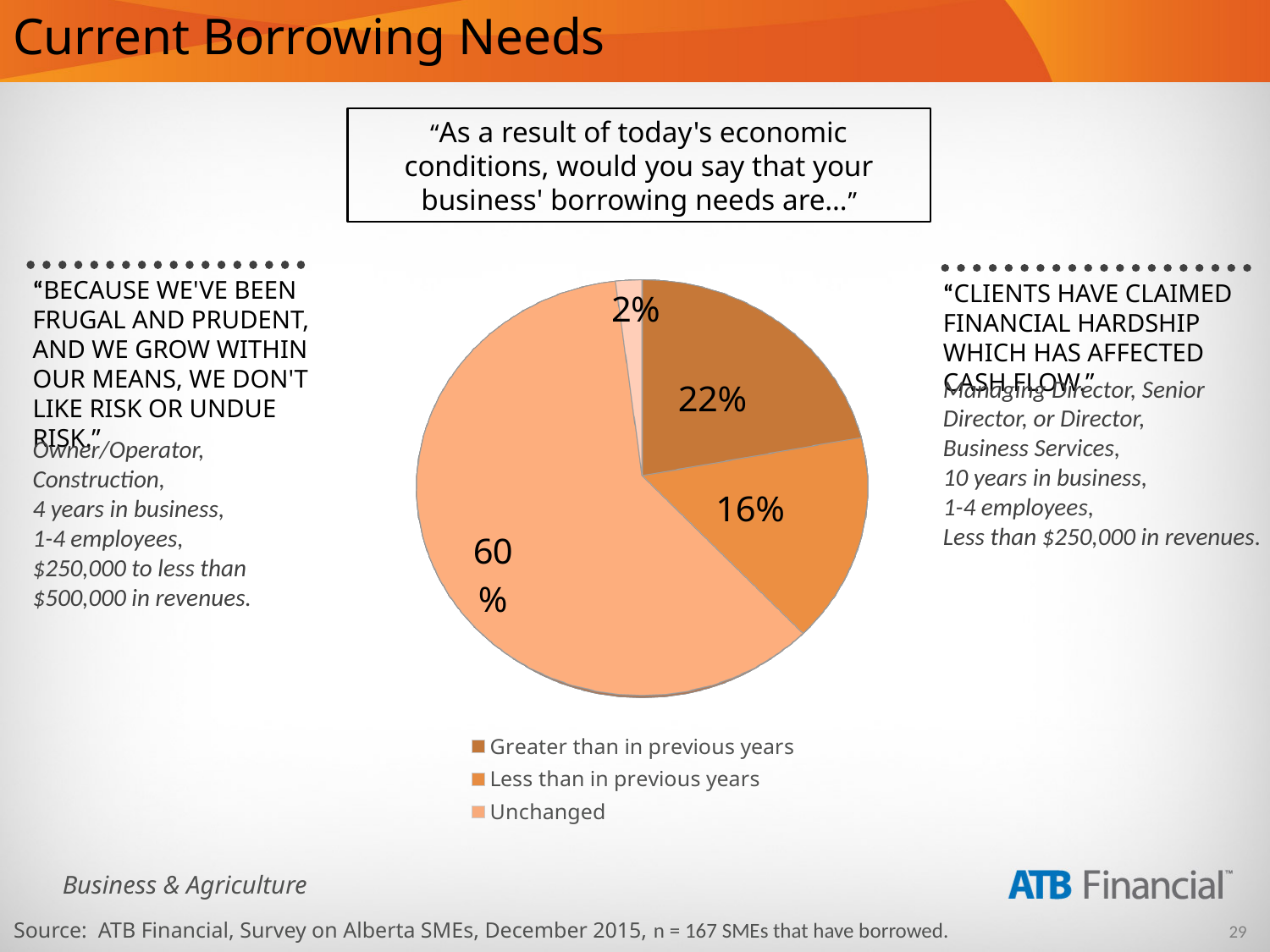
How many entries does the legend list? 3 What percentage of respondents said their borrowing needs are unchanged? 60% Which category has the largest share of the pie? Unchanged What percentage of respondents said their borrowing needs are greater than in previous years? 22% What is the difference between the 'Unchanged' share and the 'Greater than in previous years' share? 38% How many slices does the pie chart have? 4 Which is larger: the share for 'Greater than in previous years' or 'Less than in previous years'? Greater than in previous years What percentage of respondents said their borrowing needs are less than in previous years? 16% What is the combined share of 'Greater than in previous years' and 'Less than in previous years'? 38% What is the difference between the 'Greater than in previous years' share and the 'Less than in previous years' share? 6% What kind of chart is shown on the slide? pie chart What is the smallest percentage labelled on the pie? 2%